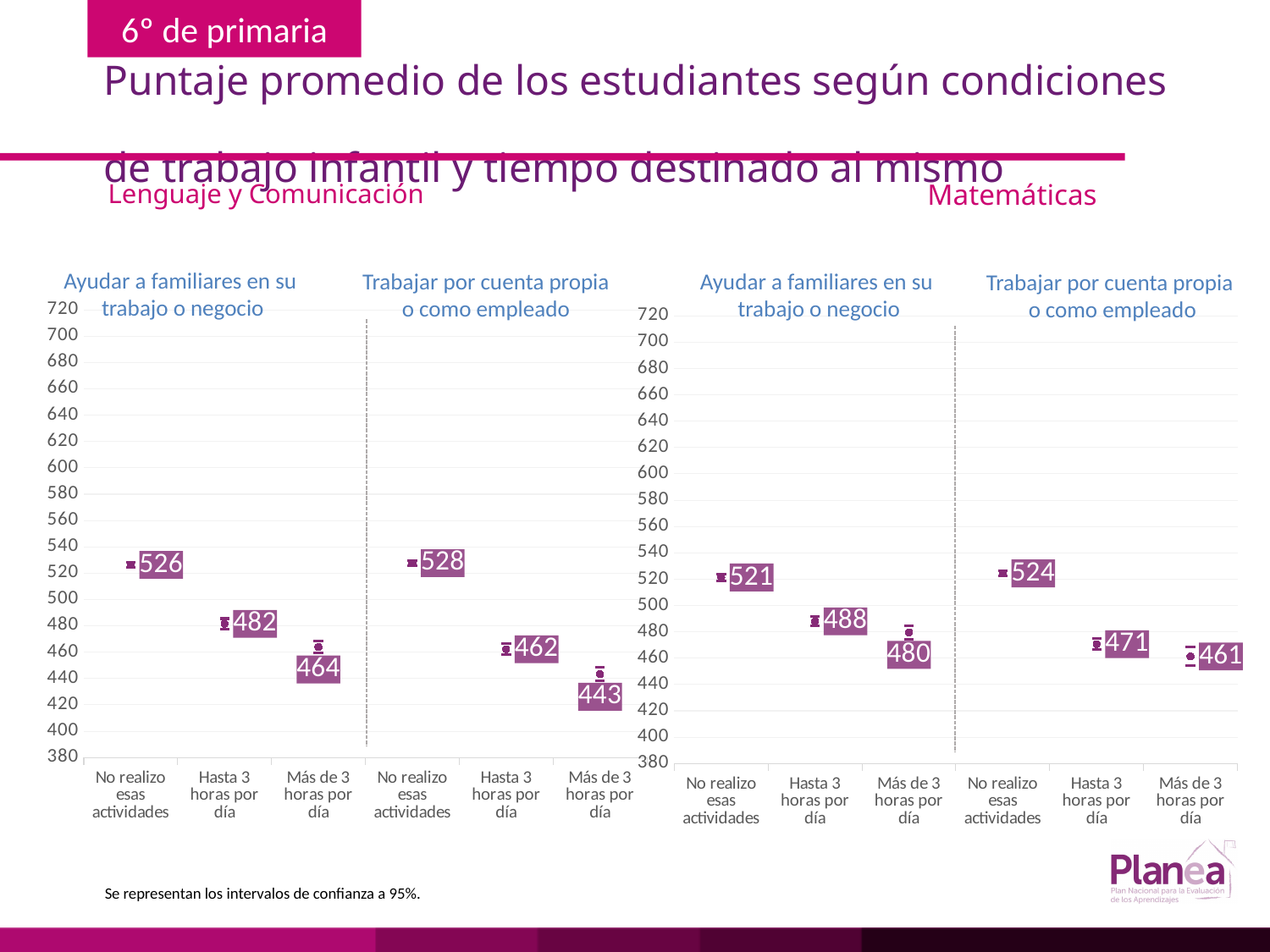
In the Matemáticas chart, which is larger: the score for helping family members more than 3 hours per day or the score for working on one's own more than 3 hours per day? Helping family members more than 3 hours per day (480) In the Matemáticas chart, which category has the highest average score? No realizo esas actividades (Trabajar por cuenta propia o como empleado) In the Lenguaje y Comunicación chart, what is the average score for students who do not help family members in their work or business ("No realizo esas actividades" under "Ayudar a familiares en su trabajo o negocio")? 526 In the Lenguaje y Comunicación chart, what is the difference between the score for students who do not help family members (526) and those who help more than 3 hours per day (464)? 62 How many data points are plotted in the Matemáticas chart? 6 What does the note at the bottom of the slide say is represented in the charts? Los intervalos de confianza a 95% In the Matemáticas chart, what is the difference between the score for students who do not work on their own (524) and those who work more than 3 hours per day (461)? 63 In the Lenguaje y Comunicación chart, what is the average score for students who work on their own or as employees more than 3 hours per day? 443 In the Matemáticas chart, what is the average score for students who help family members up to 3 hours per day? 488 In the Lenguaje y Comunicación chart, do the scores rise or fall as the hours spent helping family members increase? Fall In the Matemáticas chart, what is the average score for students who work on their own or as employees up to 3 hours per day? 471 In the Lenguaje y Comunicación chart, which category has the lowest average score? Más de 3 horas por día (Trabajar por cuenta propia o como empleado)